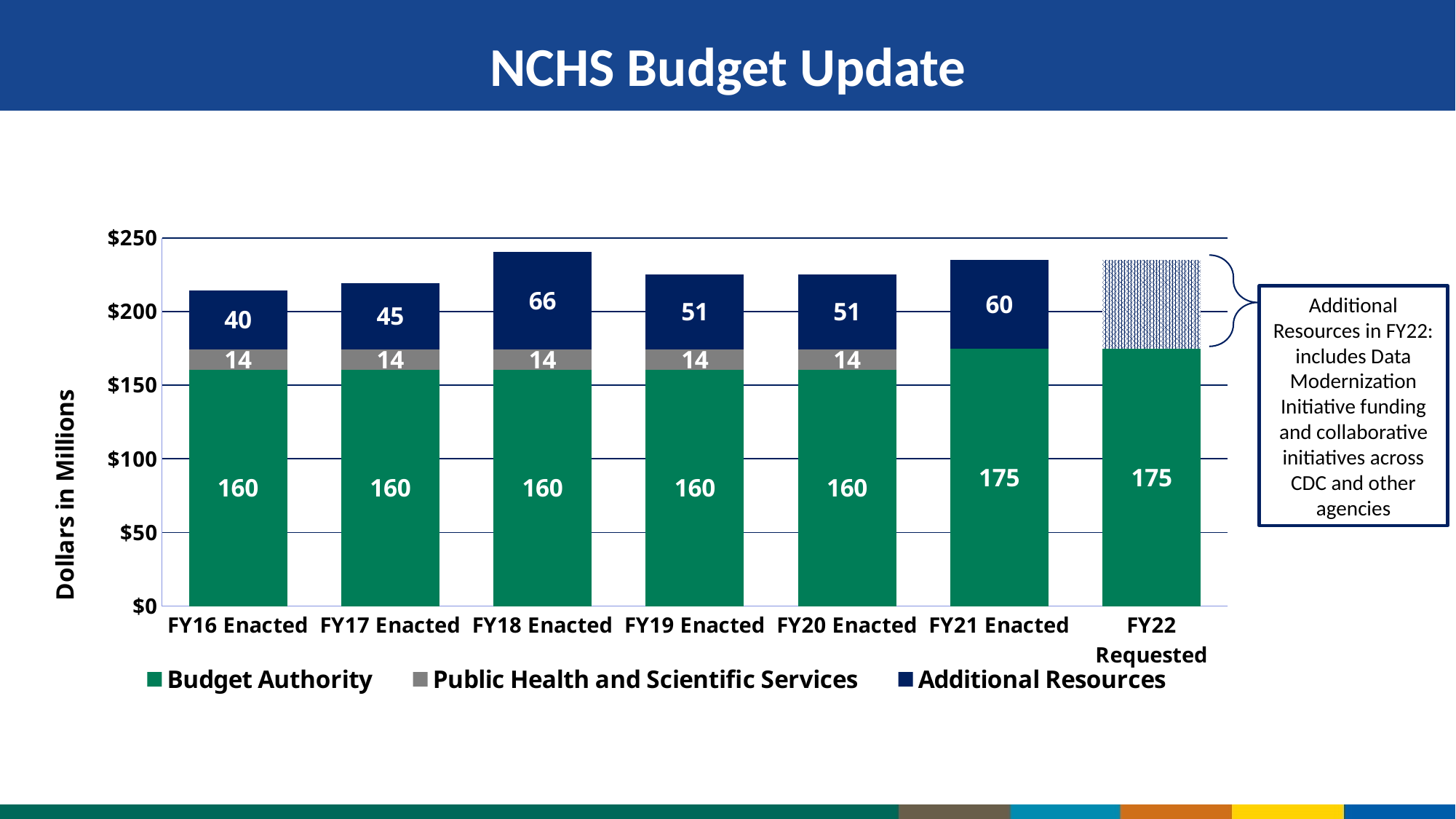
What is the difference between the Additional Resources values for FY18 Enacted and FY16 Enacted? 26 Which fiscal year has the lowest Additional Resources value? FY16 Enacted How many series does the legend list? 3 Which fiscal year has the highest Additional Resources value? FY18 Enacted Is the total height of the FY22 Requested bar greater or less than $200? greater What is the total of the stacked bar for FY18 Enacted? 240 What is the Additional Resources value for FY18 Enacted? 66 What is the Budget Authority value for FY16 Enacted? 160 Which is larger, the Additional Resources value for FY17 Enacted or for FY21 Enacted? FY21 Enacted What is the Budget Authority value for FY22 Requested? 175 How many fiscal year categories are shown on the x axis? 7 What kind of chart is shown on the slide? Stacked bar chart